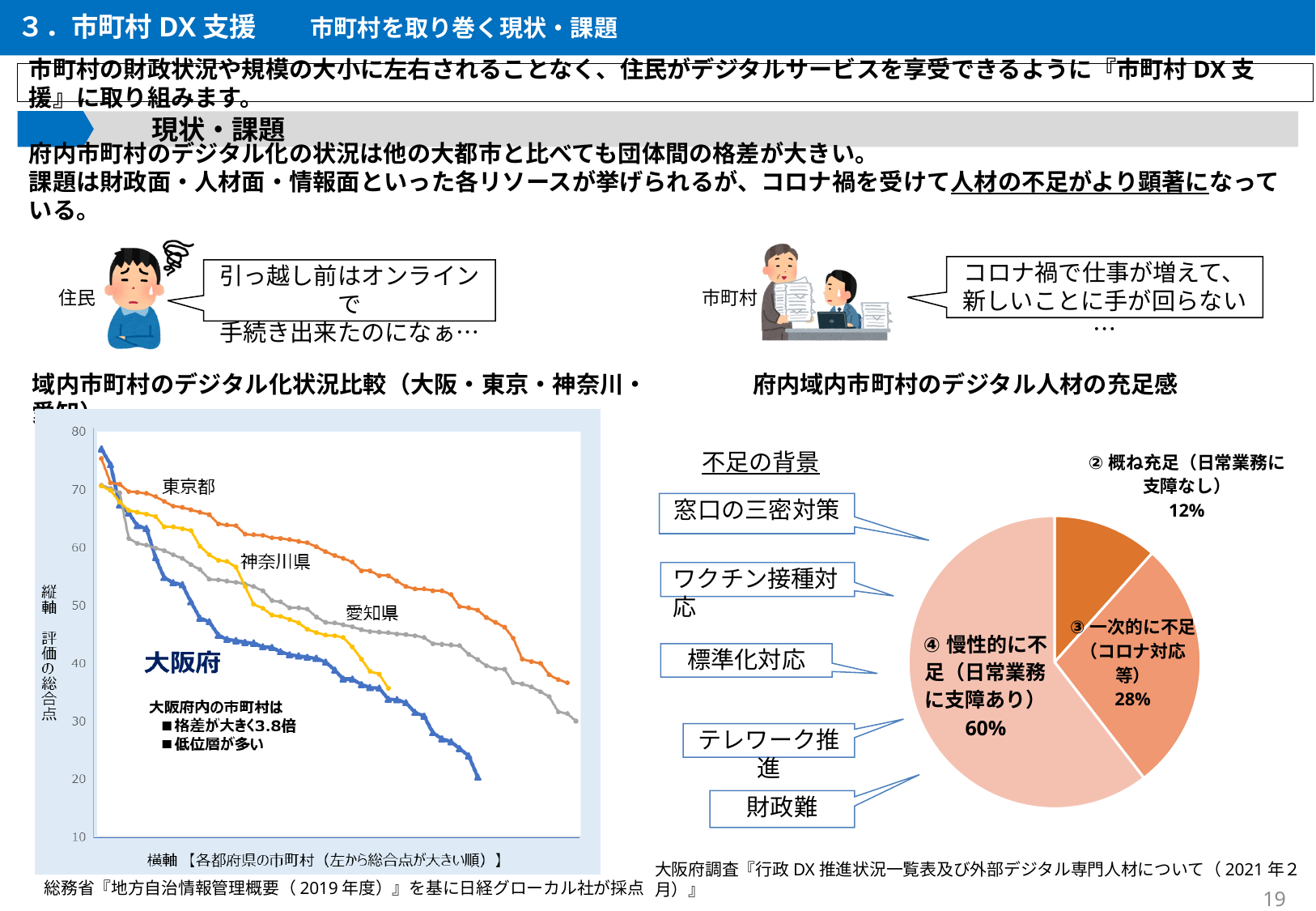
What kind of chart is the chart on the right (府内域内市町村のデジタル人材の充足感)? pie chart In the pie chart on the right, how many slices are there? 3 In the pie chart on the right, what is the difference in percentage points between ④ 慢性的に不足 and ③ 一次的に不足? 32 In the pie chart on the right (府内域内市町村のデジタル人材の充足感), what share is labelled ④ 慢性的に不足（日常業務に支障あり）? 60% In the pie chart on the right, what share is labelled ③ 一次的に不足（コロナ対応等）? 28% In the pie chart on the right, which category has the largest share? ④ 慢性的に不足（日常業務に支障あり） In the line chart on the left, how many prefectures are plotted as lines? 4 In the pie chart on the right, what share is labelled ② 概ね充足（日常業務に支障なし）? 12% In the line chart on the left, do the values for 大阪府 rise or fall from left to right along the x axis? fall In the pie chart on the right, which category has the smallest share? ② 概ね充足（日常業務に支障なし） What kind of chart is the chart on the left (域内市町村のデジタル化状況比較)? line chart In the line chart on the left, is the lowest value of the 大阪府 line greater or less than 30? less